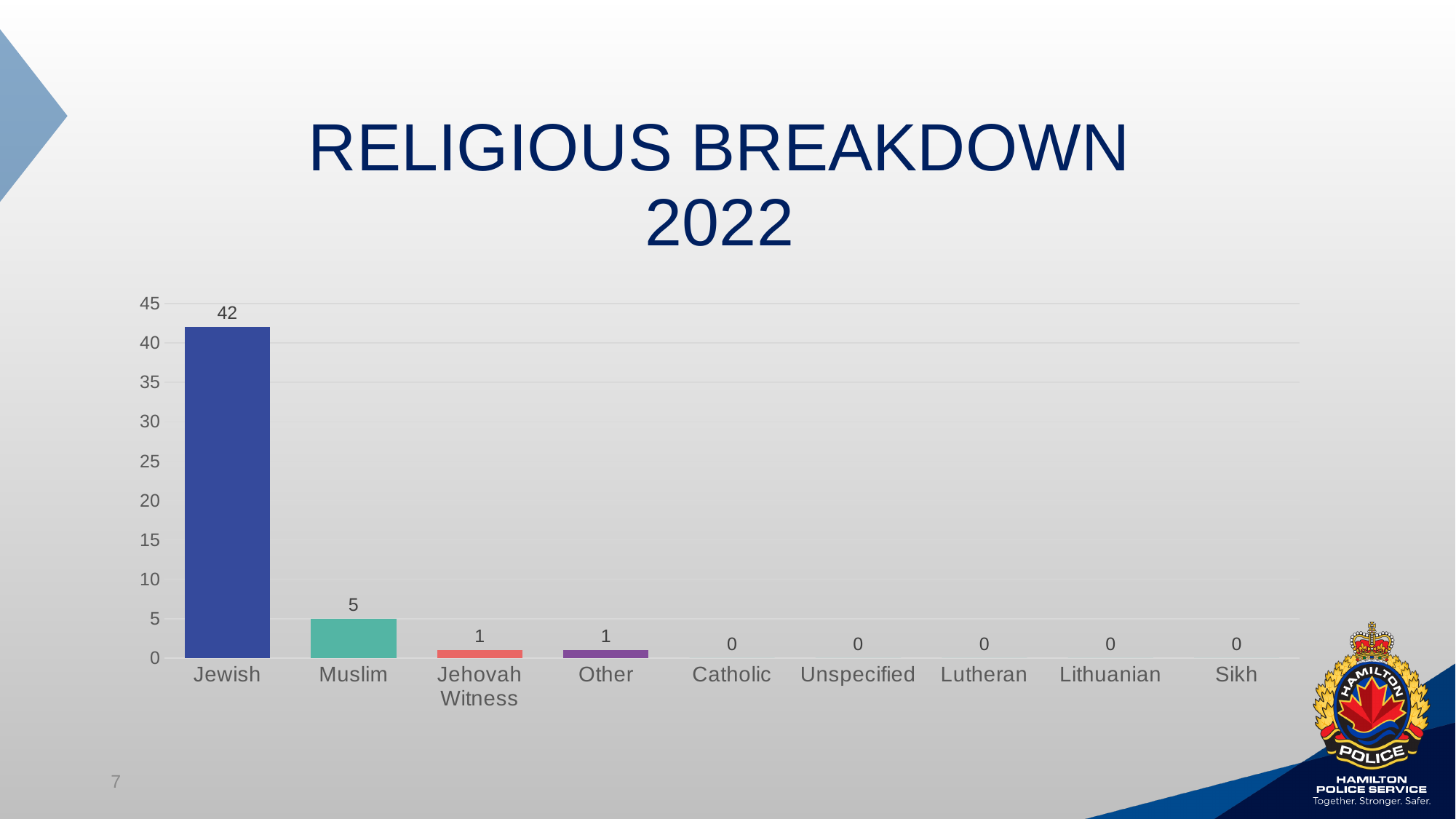
What is the title of the chart on the slide? RELIGIOUS BREAKDOWN 2022 How many categories have a value of 0? 5 Which category has the highest value? Jewish What is the value for Muslim? 5 How many categories are shown on the x axis? 9 What is the value for Jehovah Witness? 1 Is the value for Jewish greater or less than 40? greater What kind of chart is shown on the slide? bar chart What is the value for Jewish? 42 What is the value for Catholic? 0 Which is larger, the value for Muslim or the value for Other? Muslim What is the difference between the values for Jewish and Muslim? 37